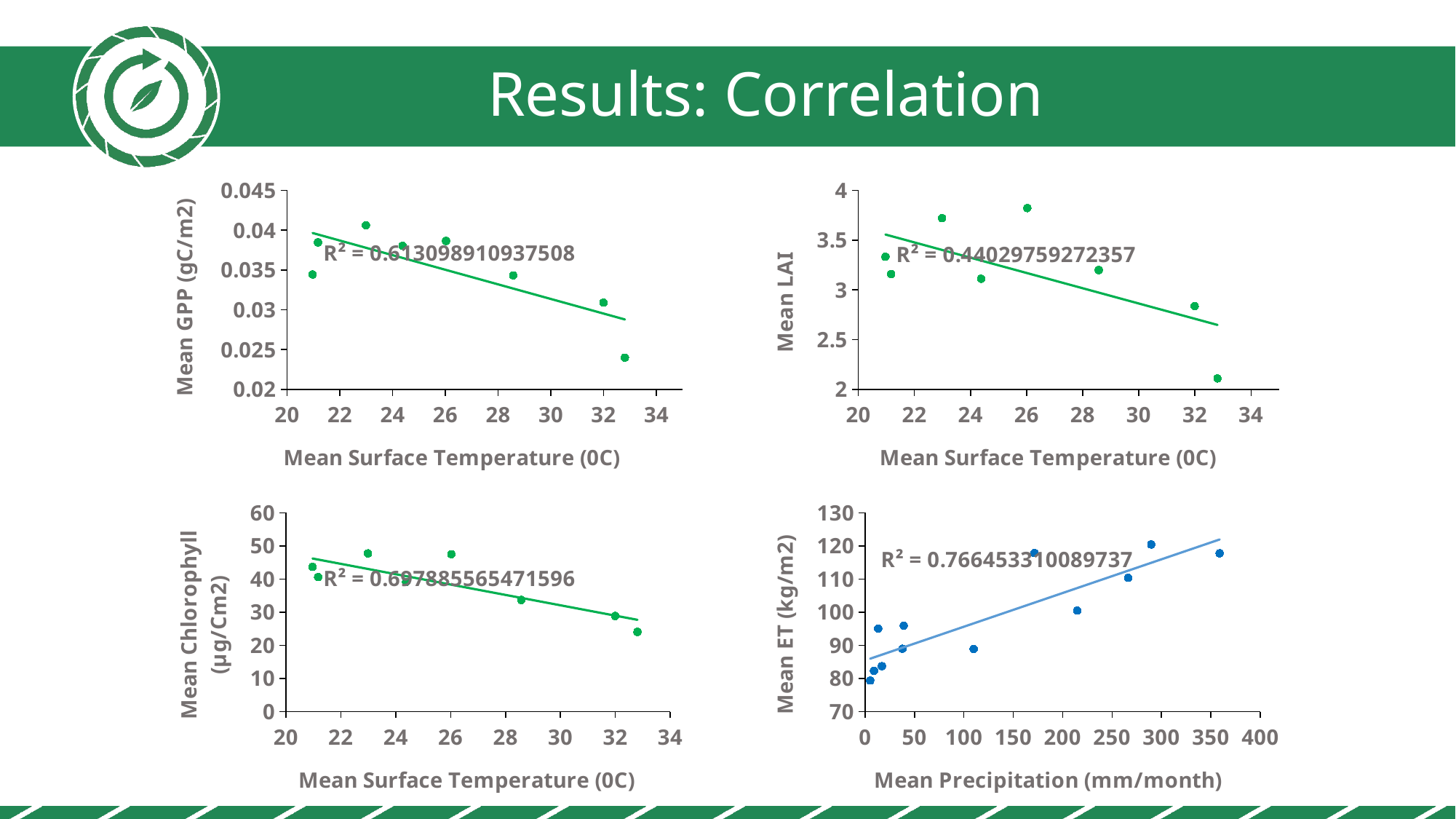
What is the x-axis label of the bottom-right chart? Mean Precipitation (mm/month) What kind of chart is the top-left chart (Mean GPP vs Mean Surface Temperature)? scatter chart In the top-left chart (Mean GPP), do the values rise or fall as Mean Surface Temperature increases? fall In the top-right chart (Mean LAI), what R² value is printed? 0.440297592272357 Which of the four charts has the highest printed R² value? the bottom-right chart (Mean ET vs Mean Precipitation) In the top-right chart (Mean LAI), is the value of the rightmost point (at about 33 °C) greater or less than 2.5? less In the bottom-left chart (Mean Chlorophyll), what R² value is printed? 0.697885565471596 In the top-left chart (Mean GPP), how many data points are plotted? 8 In the top-left chart (Mean GPP), what R² value is printed? 0.613098910937508 In the bottom-right chart (Mean ET), what R² value is printed? 0.766453310089737 In the bottom-right chart (Mean ET), is the value of the rightmost point (at about 360 mm/month) greater or less than 110? greater In the bottom-right chart (Mean ET), do the values rise or fall as Mean Precipitation increases? rise